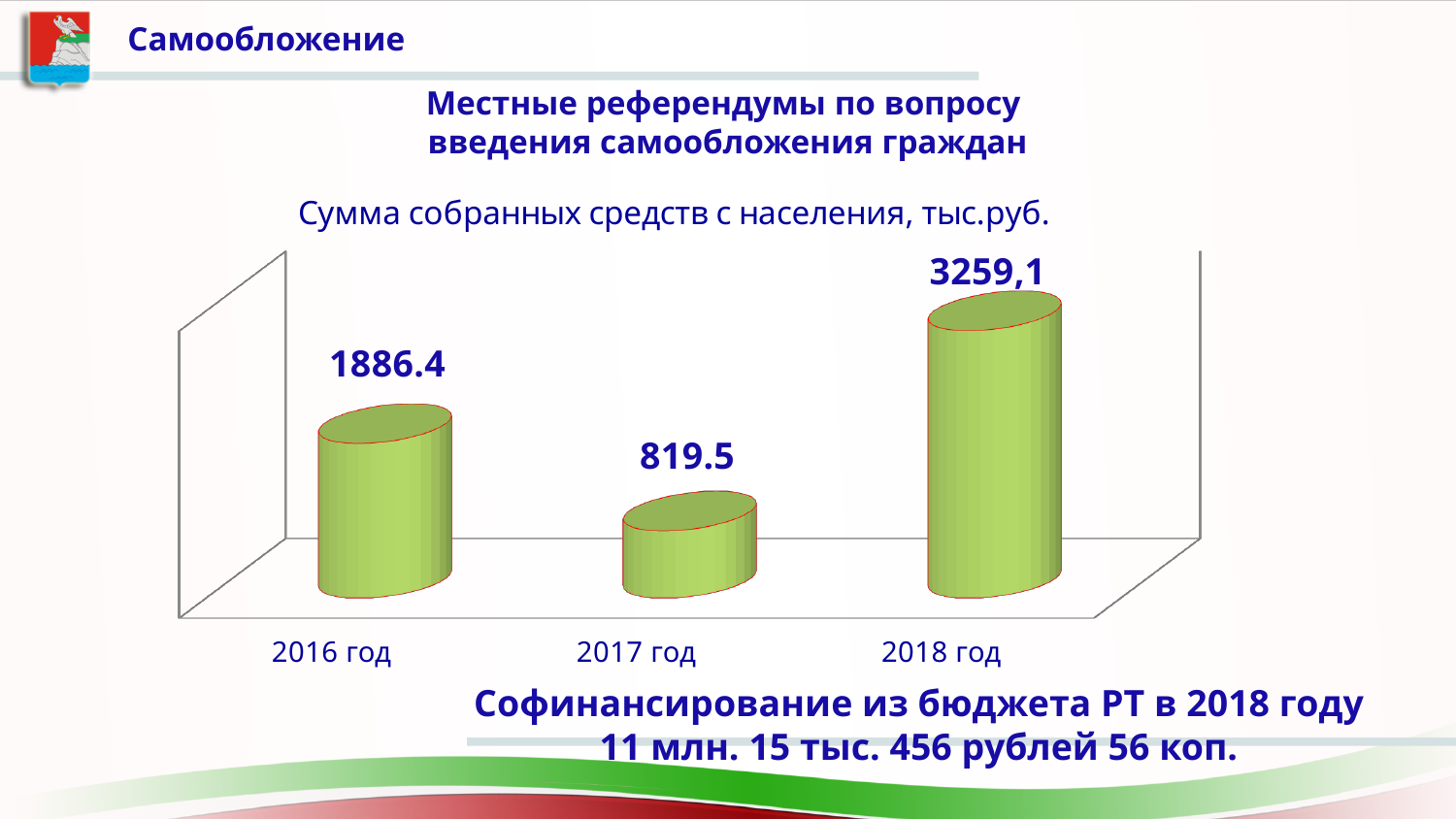
Does the value rise or fall from 2017 год to 2018 год? rise What kind of chart is shown on the slide? bar chart What is the value for 2017 год in the chart? 819.5 Which is larger, the value for 2016 год or the value for 2017 год? 2016 год How many years are shown in the chart? 3 What is the value for 2018 год in the chart? 3259,1 What is the difference between the values for 2018 год and 2016 год? 1372.7 Which year has the highest value in the chart? 2018 год Which year has the lowest value in the chart? 2017 год What is the difference between the values for 2016 год and 2017 год? 1066.9 What is the title of the chart? Сумма собранных средств с населения, тыс.руб. What is the value for 2016 год in the chart? 1886.4